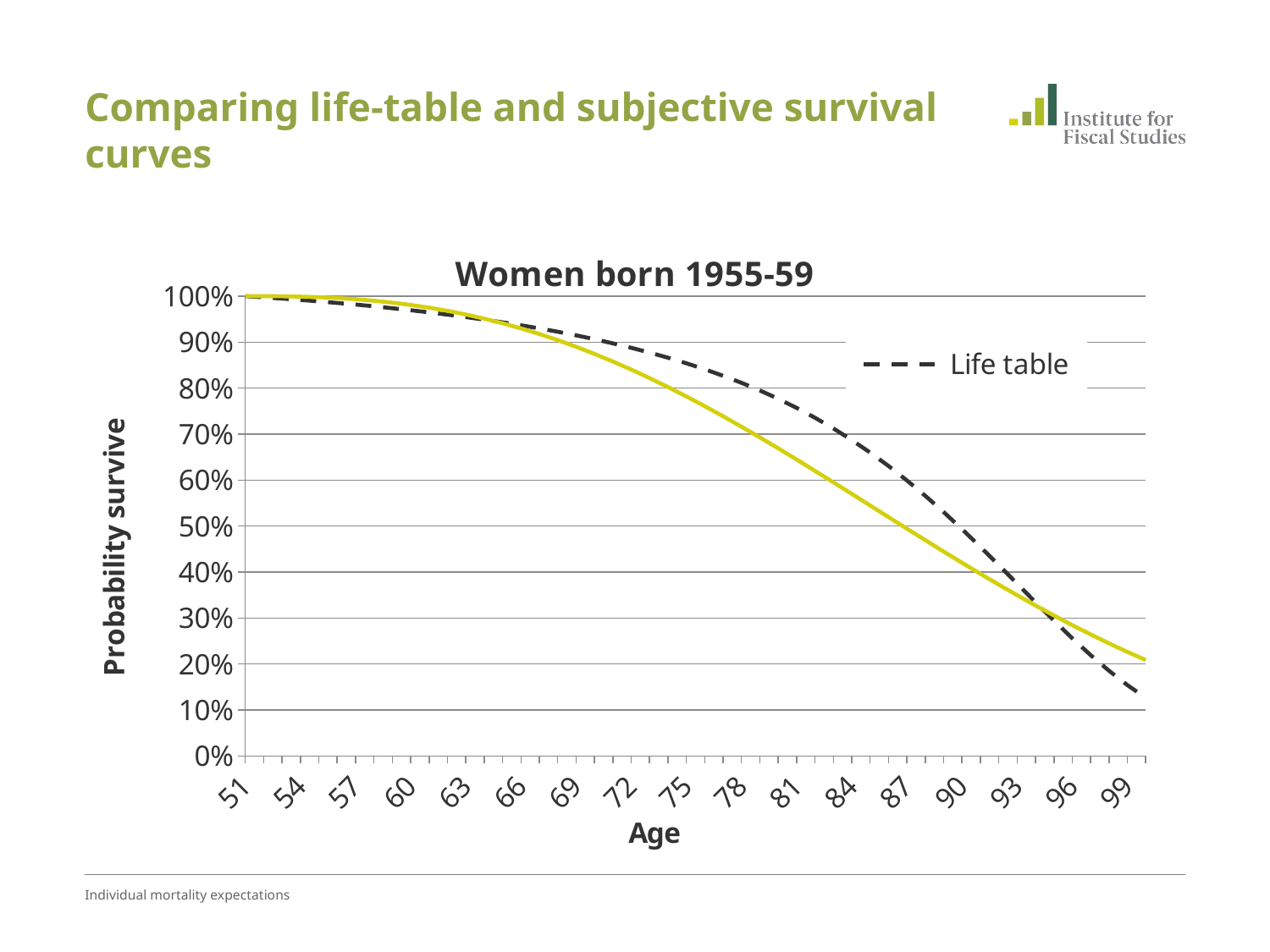
Is the Life table value at age 99 greater or less than 20%? less Is the Life table value at age 75 greater or less than 80%? greater What kind of chart is shown on the slide? Line chart At age 99, which is higher: the Life table series or the solid yellow-green line? The solid yellow-green line What is the label on the vertical axis of the chart? Probability survive At age 84, which is higher: the Life table series or the solid yellow-green line? Life table How many series does the chart's legend list? 1 What is the title of the chart? Women born 1955-59 How many age labels are shown along the x axis? 17 Is the Life table value at age 96 greater or less than 30%? less Do the values of the Life table series rise or fall as age increases? Fall